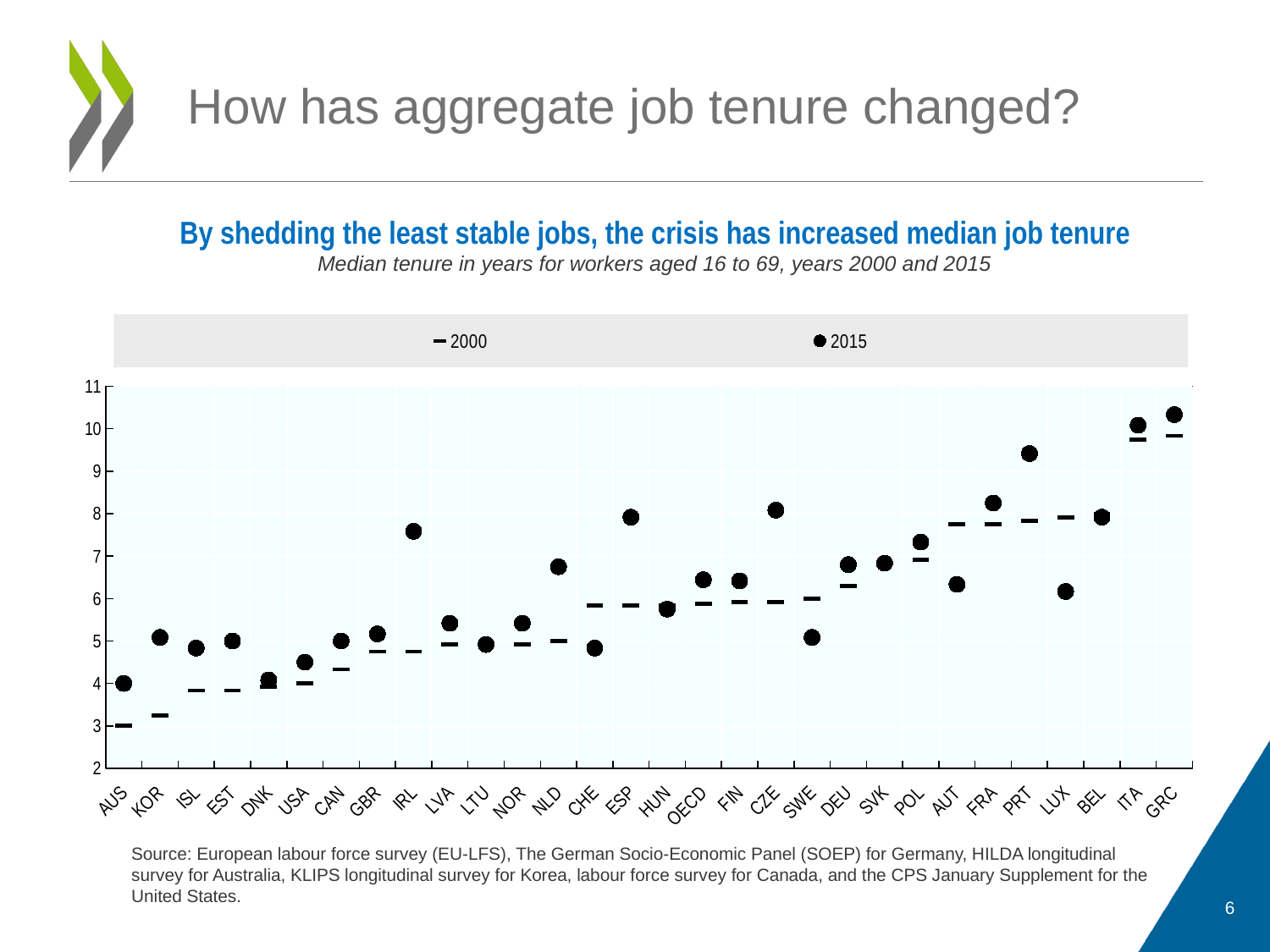
Is the 2000 value for KOR greater or less than 4? less Is the 2015 value for IRL greater or less than 7? greater Which country has the lowest 2000 value? AUS For LUX, which is larger, the 2000 value or the 2015 value? 2000 How many series does the legend list? 2 Is the 2015 value for SWE greater or less than 6? less What kind of chart is this? Scatter (dot) chart Which has the larger 2015 value, ESP or CHE? ESP What are the two series shown in the legend? 2000 and 2015 How many countries/categories are shown along the x axis? 30